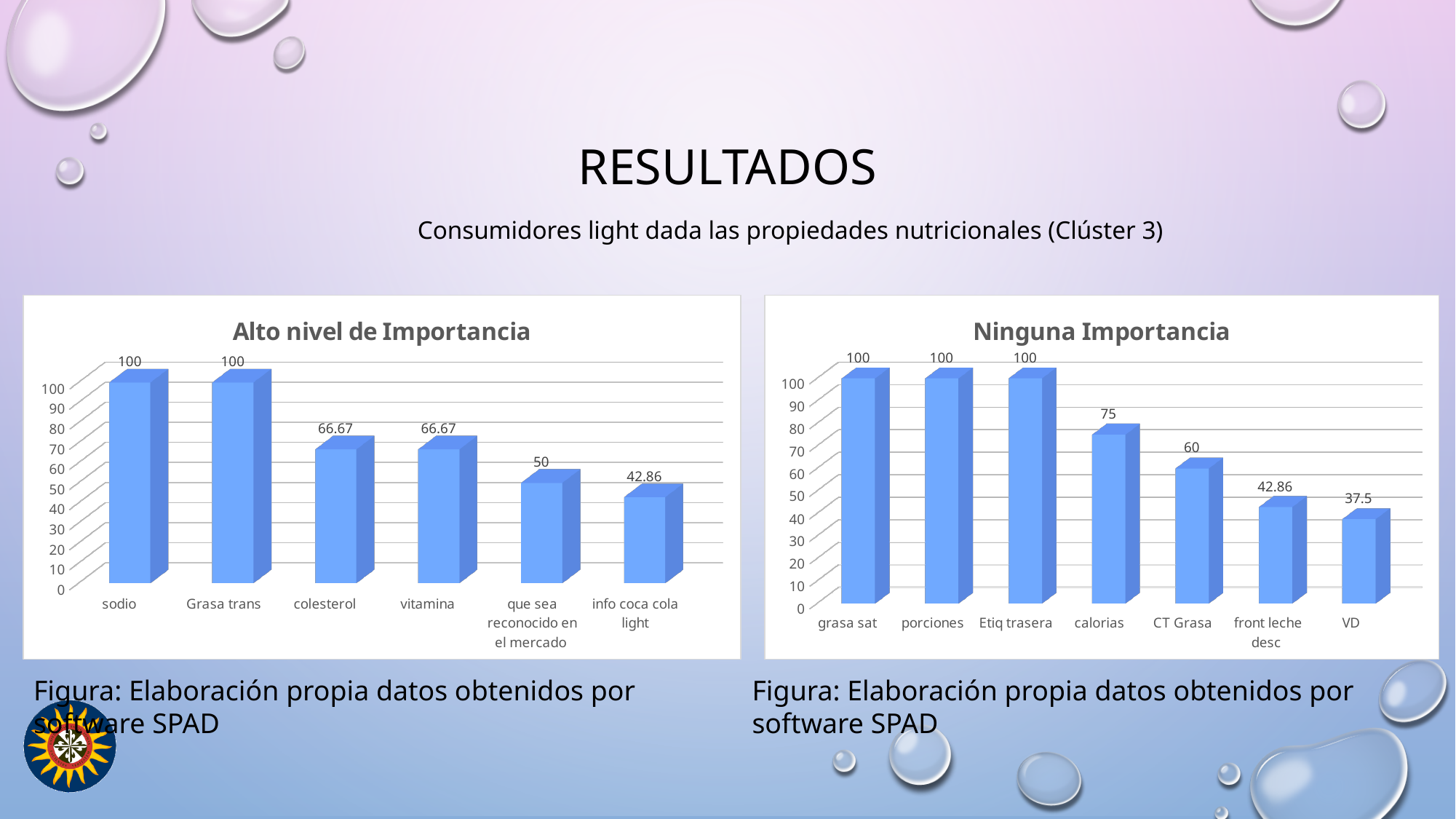
In the 'Ninguna Importancia' chart, which is larger, the value for calorias or the value for CT Grasa? calorias In the 'Ninguna Importancia' chart, what is the value for VD? 37.5 In the 'Alto nivel de Importancia' chart, what is the value for 'info coca cola light'? 42.86 In the 'Alto nivel de Importancia' chart, how many categories are shown? 6 In the 'Ninguna Importancia' chart, which category has the lowest value? VD In the 'Alto nivel de Importancia' chart, what is the value for colesterol? 66.67 What kind of chart is the 'Ninguna Importancia' chart? Bar chart In the 'Ninguna Importancia' chart, how many categories are shown? 7 In the 'Alto nivel de Importancia' chart, which category has the lowest value? info coca cola light In the 'Alto nivel de Importancia' chart, what is the difference between the values for vitamina and 'que sea reconocido en el mercado'? 16.67 In the 'Ninguna Importancia' chart, what is the value for calorias? 75 In the 'Ninguna Importancia' chart, what is the difference between the values for CT Grasa and 'front leche desc'? 17.14